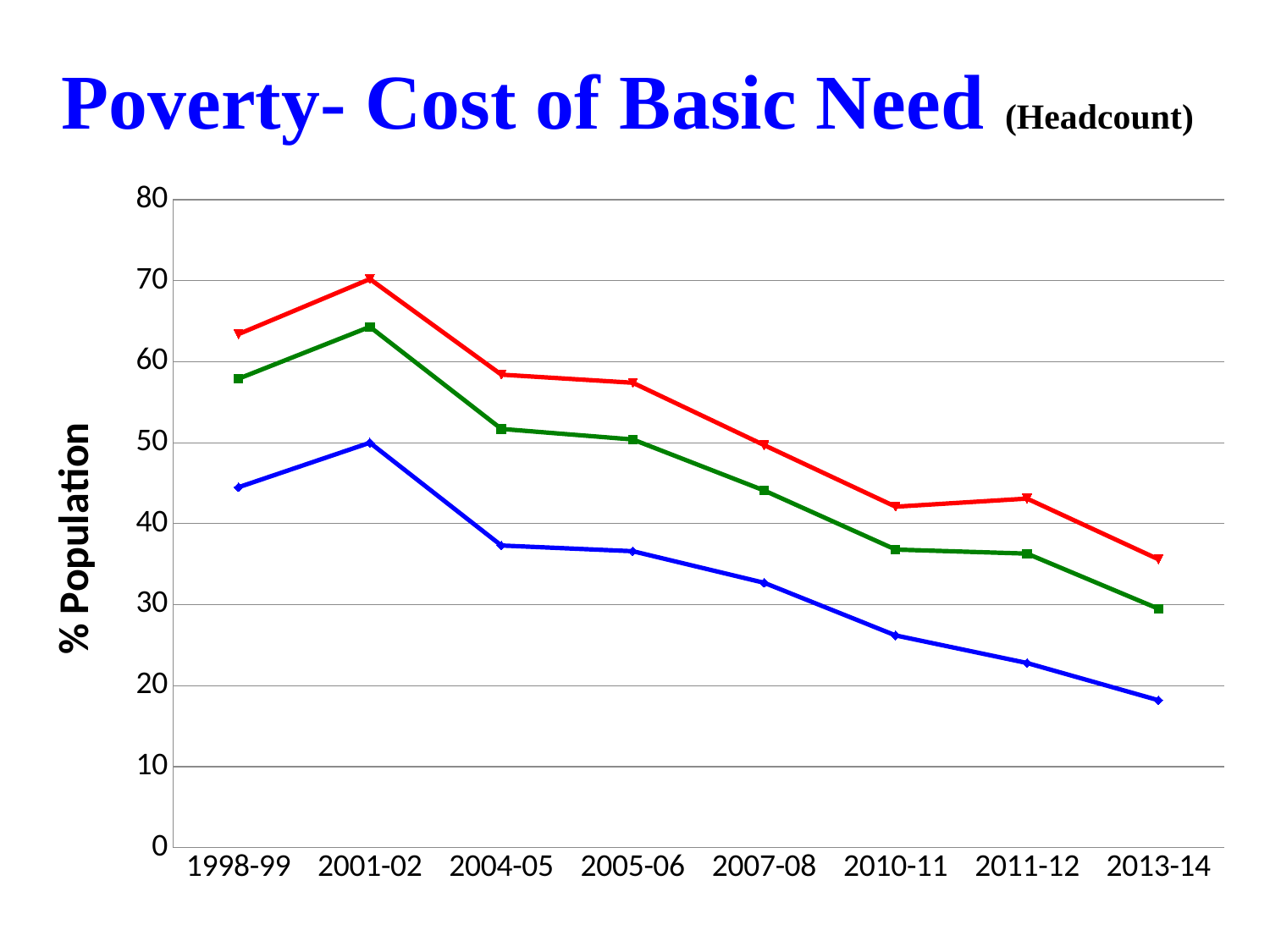
Is the value of the red line for 2001-02 greater or less than 60? greater For 2007-08, which line has the larger value, the red line or the blue line? red line What is the title of the chart on the slide? Poverty- Cost of Basic Need (Headcount) Is the value of the red line for 2013-14 greater or less than 40? less In which period does the red line reach its highest value? 2001-02 What is the label on the vertical axis? % Population How many time periods are shown on the x axis? 8 Overall, do the values of the blue line rise or fall from 1998-99 to 2013-14? fall Is the value of the green line for 2001-02 greater or less than 60? greater What kind of chart is shown on the slide? line chart In which period does the blue line reach its lowest value? 2013-14